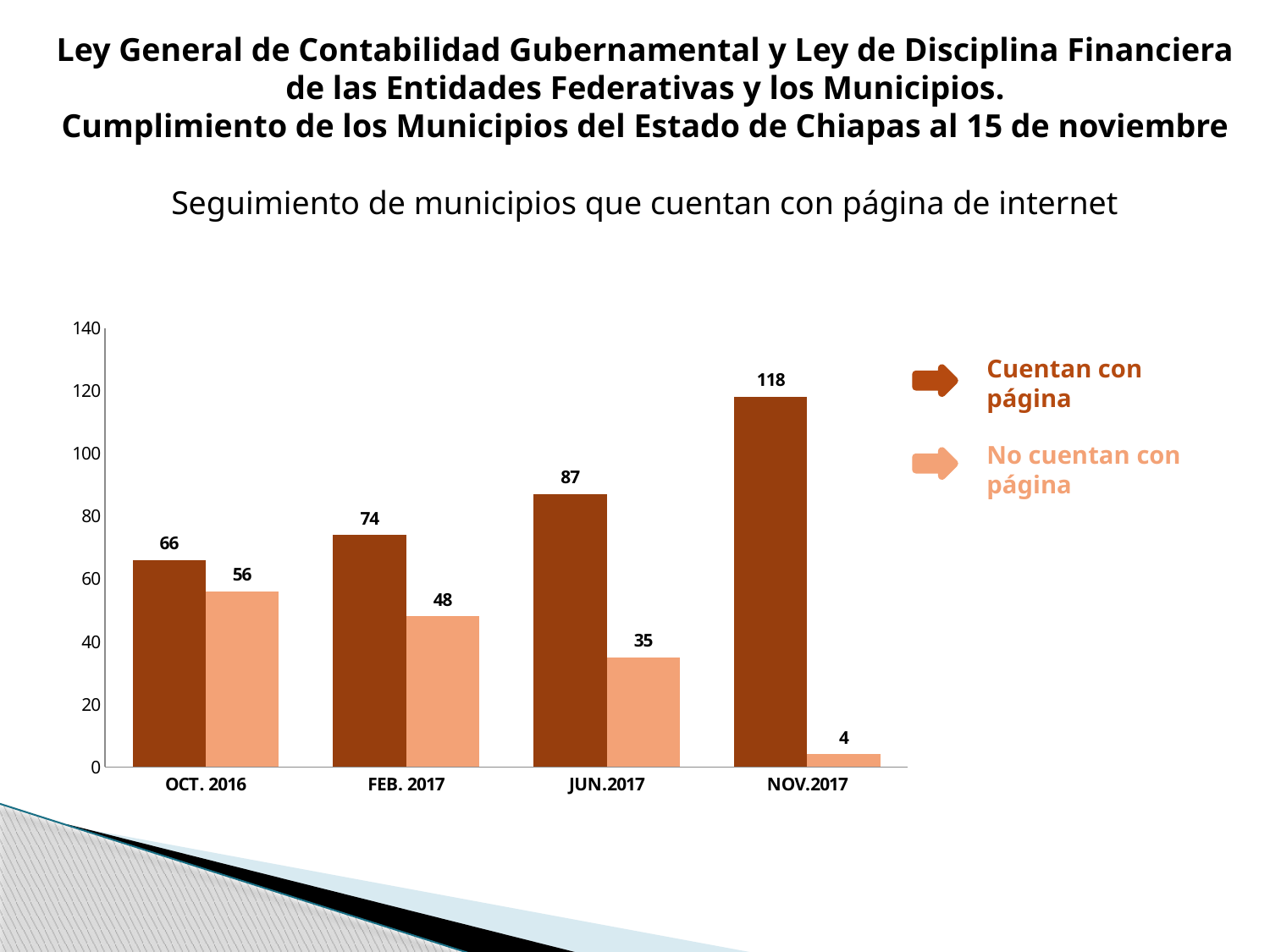
What is the value for 'Cuentan con página' in OCT. 2016? 66 How many series does the legend list? 2 Is the value for 'Cuentan con página' in JUN.2017 greater or less than 80? greater What is the difference between 'Cuentan con página' and 'No cuentan con página' in JUN.2017? 52 Do the 'No cuentan con página' values rise or fall from OCT. 2016 to NOV.2017? Fall In which period is the 'Cuentan con página' value highest? NOV.2017 How many periods are shown on the x axis? 4 What is the value for 'No cuentan con página' in FEB. 2017? 48 What is the value for 'Cuentan con página' in NOV.2017? 118 Which is larger in OCT. 2016: 'Cuentan con página' or 'No cuentan con página'? Cuentan con página In which period is the 'No cuentan con página' value lowest? NOV.2017 What kind of chart is shown on the slide? Bar chart